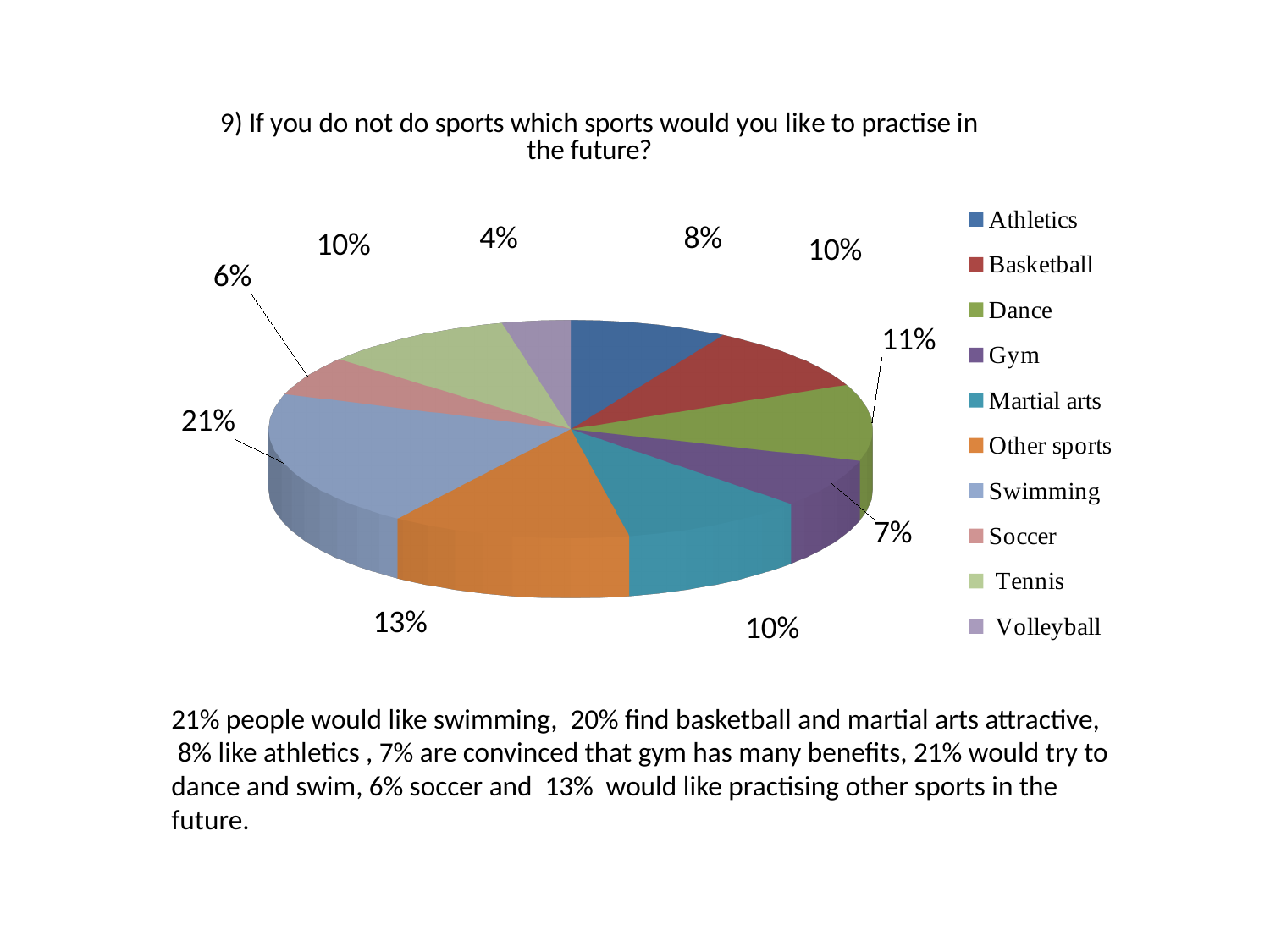
What is the difference in percentage points between Swimming and Other sports? 8 What percentage of the pie is Swimming? 21% What type of chart is shown on the slide? Pie chart How many categories does the legend list? 10 Which sport has the largest slice of the pie? Swimming What is the title of the chart? 9) If you do not do sports which sports would you like to practise in the future? What percentage of the pie is Other sports? 13% Which sport has the smallest slice of the pie? Volleyball What percentage of the pie is Gym? 7% What percentage of the pie is Volleyball? 4% What percentage of the pie is Dance? 11% Which has a larger share, Athletics or Dance? Dance